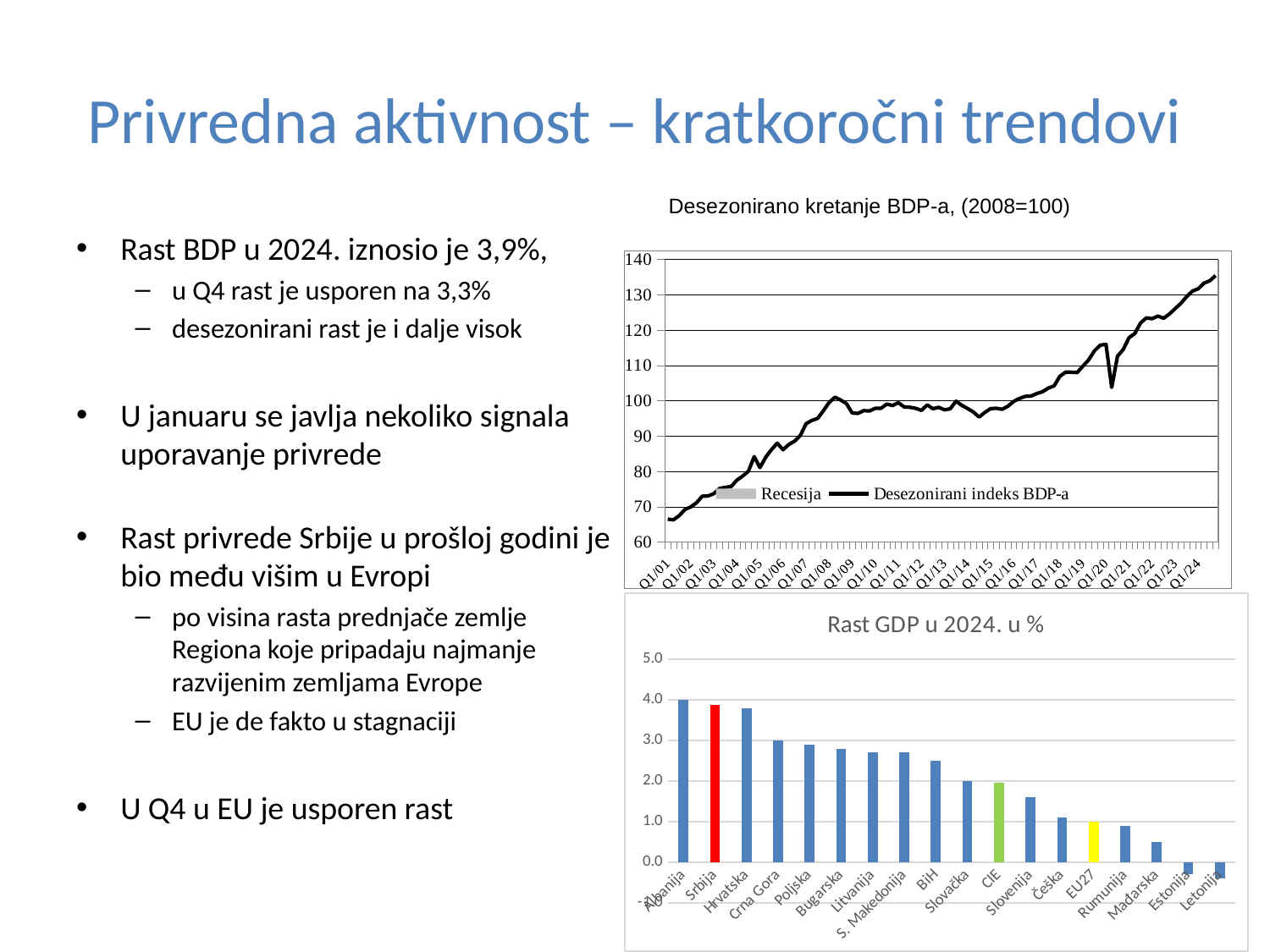
In the top chart 'Desezonirano kretanje BDP-a, (2008=100)', does the index generally rise or fall from Q1/01 to Q1/24? rise In the bottom chart 'Rast GDP u 2024. u %', what colour is the bar for Srbija? red In the bottom chart 'Rast GDP u 2024. u %', is the value for Hrvatska greater or less than 3.0? greater In the bottom chart 'Rast GDP u 2024. u %', is the value for Slovenija greater or less than 2.0? less What kind of chart is the top chart 'Desezonirano kretanje BDP-a, (2008=100)'? line chart In the bottom chart 'Rast GDP u 2024. u %', is the value for Mađarska greater or less than 1.0? less How many series does the legend of the top chart 'Desezonirano kretanje BDP-a, (2008=100)' list? 2 What kind of chart is the bottom chart titled 'Rast GDP u 2024. u %'? bar chart In the bottom chart 'Rast GDP u 2024. u %', which is larger, the value for Albanija or the value for Slovačka? Albanija In the bottom chart 'Rast GDP u 2024. u %', how many categories have a negative value? 2 In the bottom chart 'Rast GDP u 2024. u %', how many countries/regions are shown on the x axis? 18 In the bottom chart 'Rast GDP u 2024. u %', which category has the highest value? Albanija